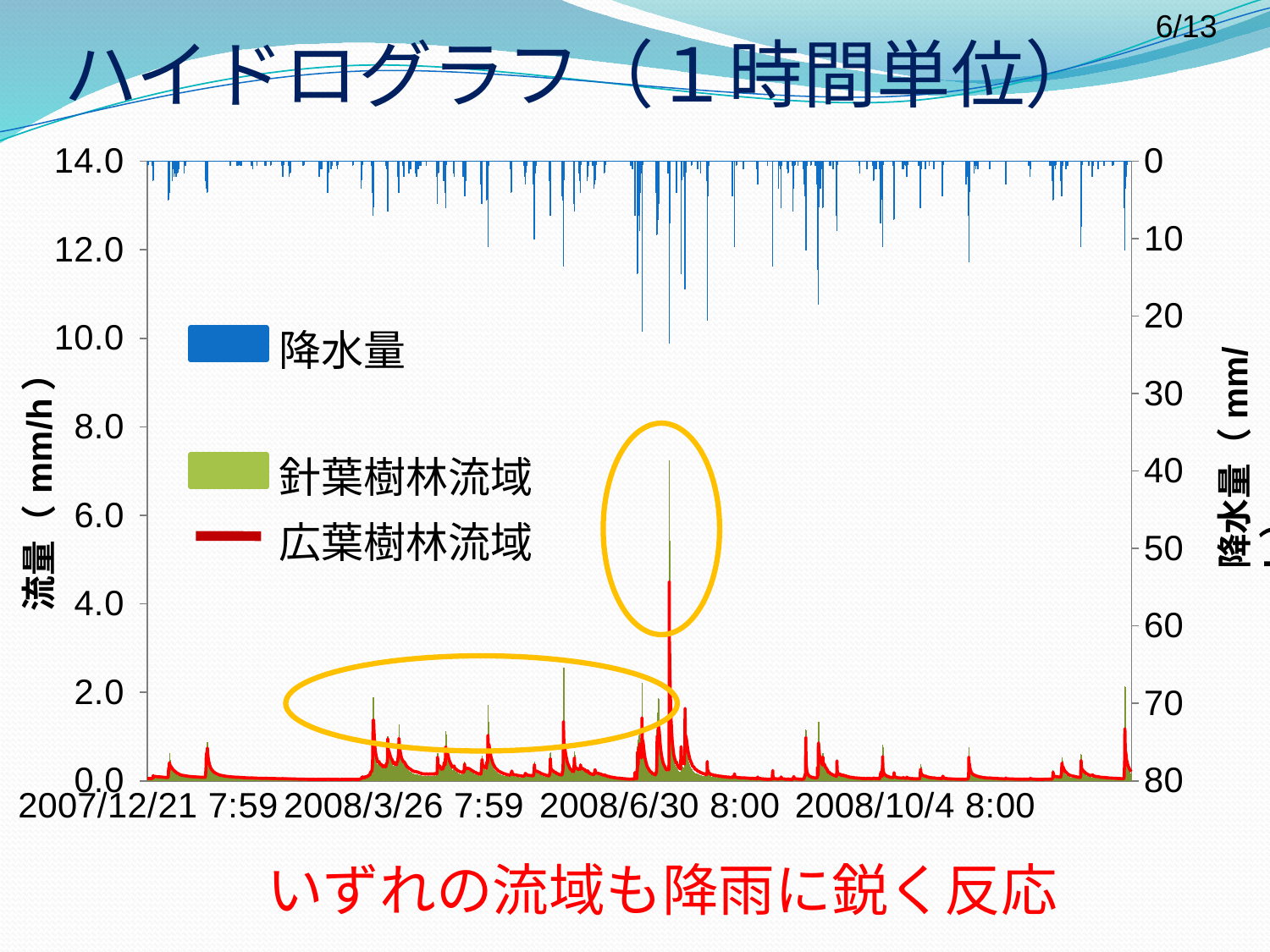
At the largest flow peak near 2008/6/30, which series reaches a higher value, 針葉樹林流域 or 広葉樹林流域? 針葉樹林流域 Which series in the legend is drawn in blue? 降水量 Is the highest peak of the 針葉樹林流域 series (near 2008/6/30) greater or less than 8.0 mm/h? less What is the label of the left vertical axis? 流量（mm/h） Is the highest peak of the 広葉樹林流域 series (near 2008/6/30) greater or less than 4.0 mm/h? greater What is the maximum value shown on the left vertical axis? 14.0 Is the highest peak of the 針葉樹林流域 series (near 2008/6/30) greater or less than 6.0 mm/h? greater How many series does the chart legend list? 3